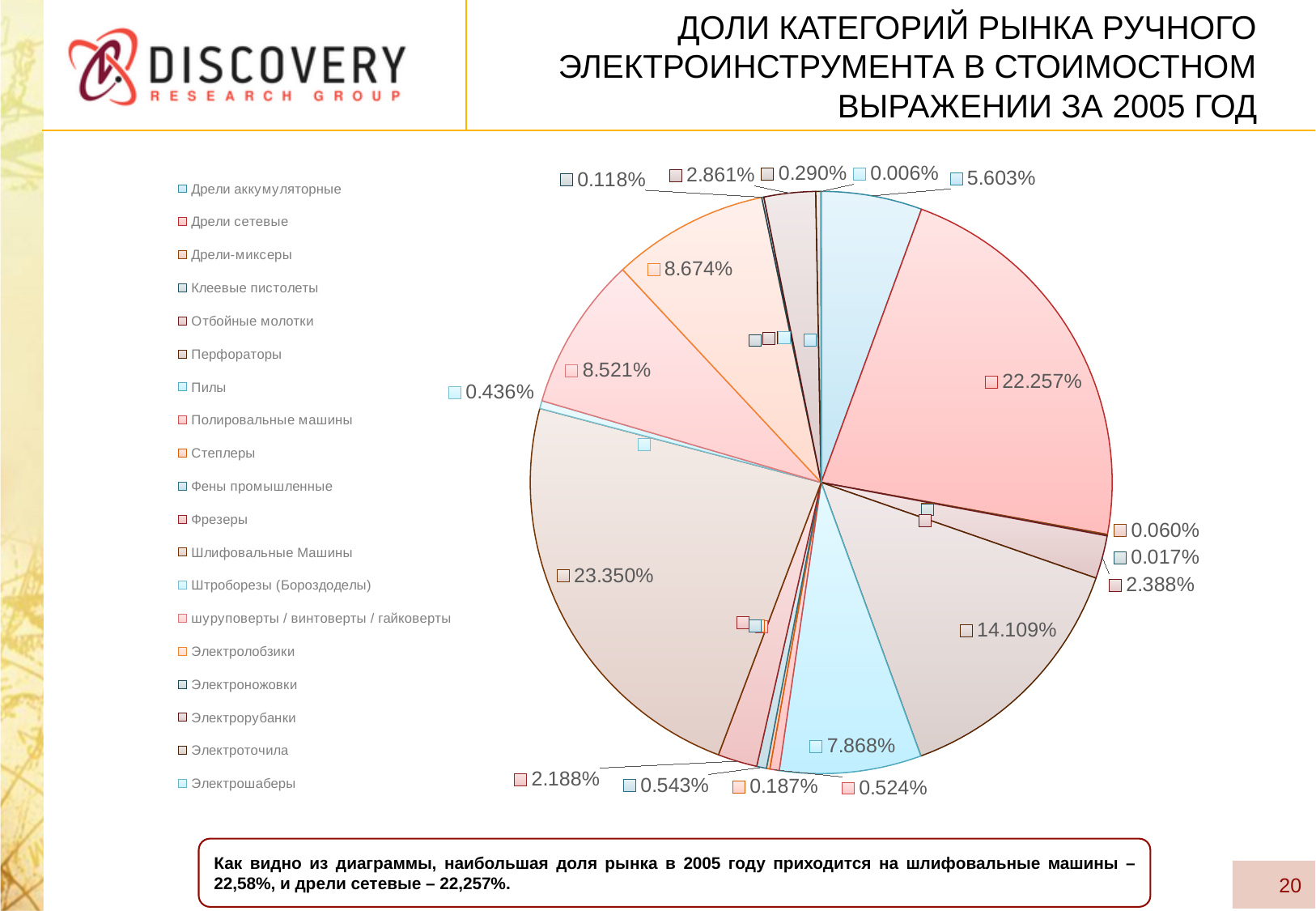
What share is shown for Перфораторы? 14.109% What is the largest share shown on the pie chart? 23.350% What kind of chart is shown on the slide? pie chart How many categories does the legend of the pie chart list? 19 What share of the market does the slice for Дрели сетевые have? 22.257% What share is shown for Пилы? 7.868% What is the difference between the largest share (23.350%) and the share for Дрели сетевые (22.257%)? 1.093% Which year does the chart title say the market shares refer to? 2005 Which category has the largest share on the pie chart? Шлифовальные Машины What is the smallest share printed on the pie chart? 0.006% Which has the larger share, Перфораторы or Пилы? Перфораторы What share is shown for Дрели аккумуляторные? 5.603%